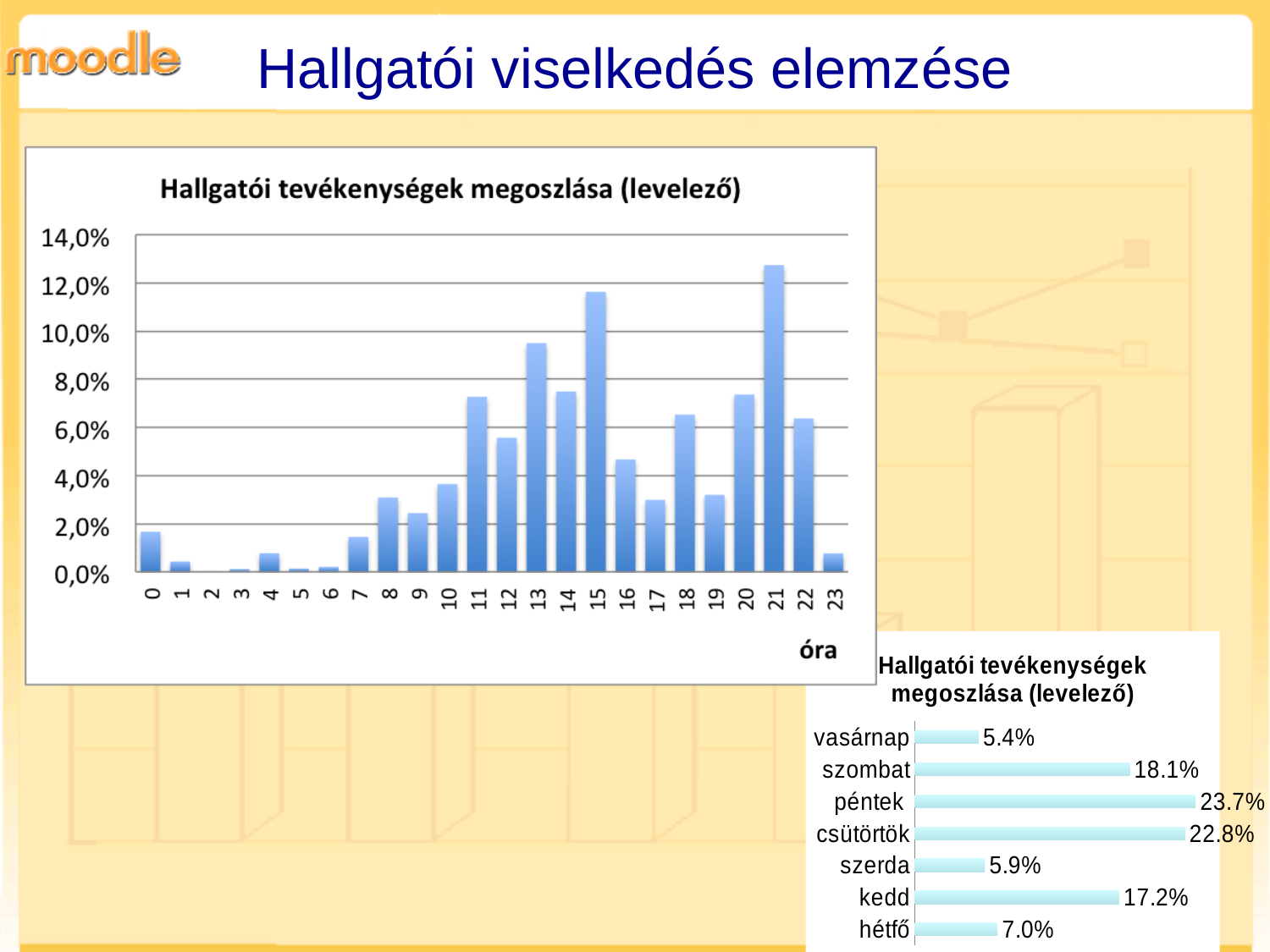
In the weekday chart on the right, how many days are listed? 7 In the hourly chart on the left, which hour has the highest share of student activity? 21 In the hourly chart on the left, is the value for hour 13 greater or less than 8,0%? greater In the weekday chart on the right, which is larger, the value for kedd or the value for szombat? szombat What type of chart is the chart on the left? bar chart In the hourly chart on the left, is the value for hour 21 greater or less than 12,0%? greater In the weekday chart on the right, which day has the lowest value? vasárnap In the hourly chart on the left, how many hour categories are shown on the x axis? 24 In the weekday chart on the right, what is the difference between the values for péntek and csütörtök? 0.9% In the hourly chart on the left, is the value for hour 0 greater or less than 2,0%? less In the weekday chart on the right, what is the value for péntek? 23.7% In the hourly chart on the left, which is larger, the value for hour 15 or the value for hour 18? hour 15